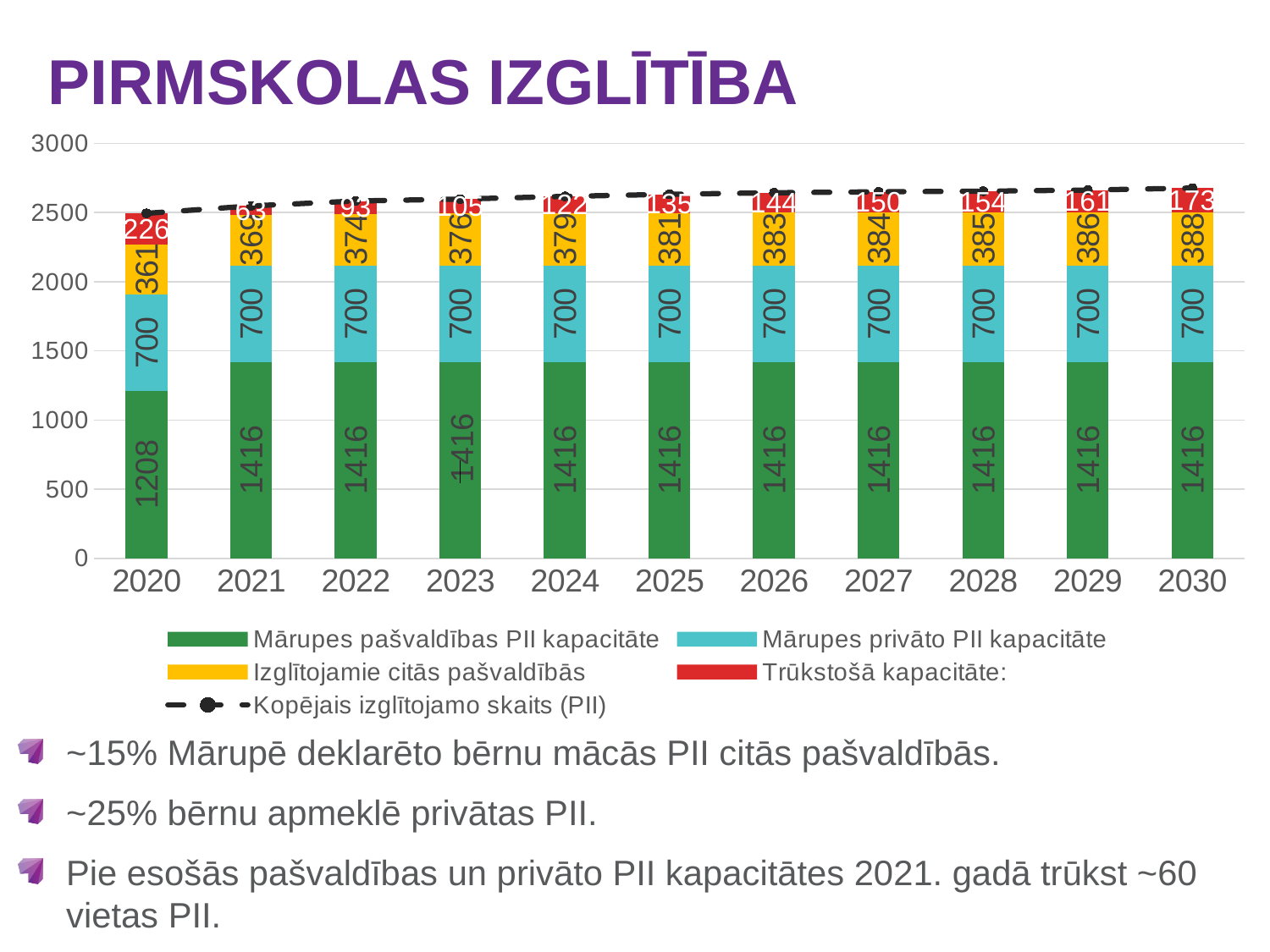
In which year is Izglītojamie citās pašvaldībās highest? 2030 What is the value of Trūkstošā kapacitāte in 2030? 173 In which year is Trūkstošā kapacitāte lowest? 2021 What is the value of Mārupes privāto PII kapacitāte in 2025? 700 What is the total of the stacked bar for 2030? 2677 What is the value of Izglītojamie citās pašvaldībās in 2030? 388 What is the value of Trūkstošā kapacitāte in 2024? 122 What kind of chart is shown on the slide? combination bar and line chart How many years are shown on the x axis? 11 How many series does the legend list? 5 What is the difference between Mārupes pašvaldības PII kapacitāte in 2021 and in 2020? 208 What is the value of Mārupes pašvaldības PII kapacitāte in 2020? 1208